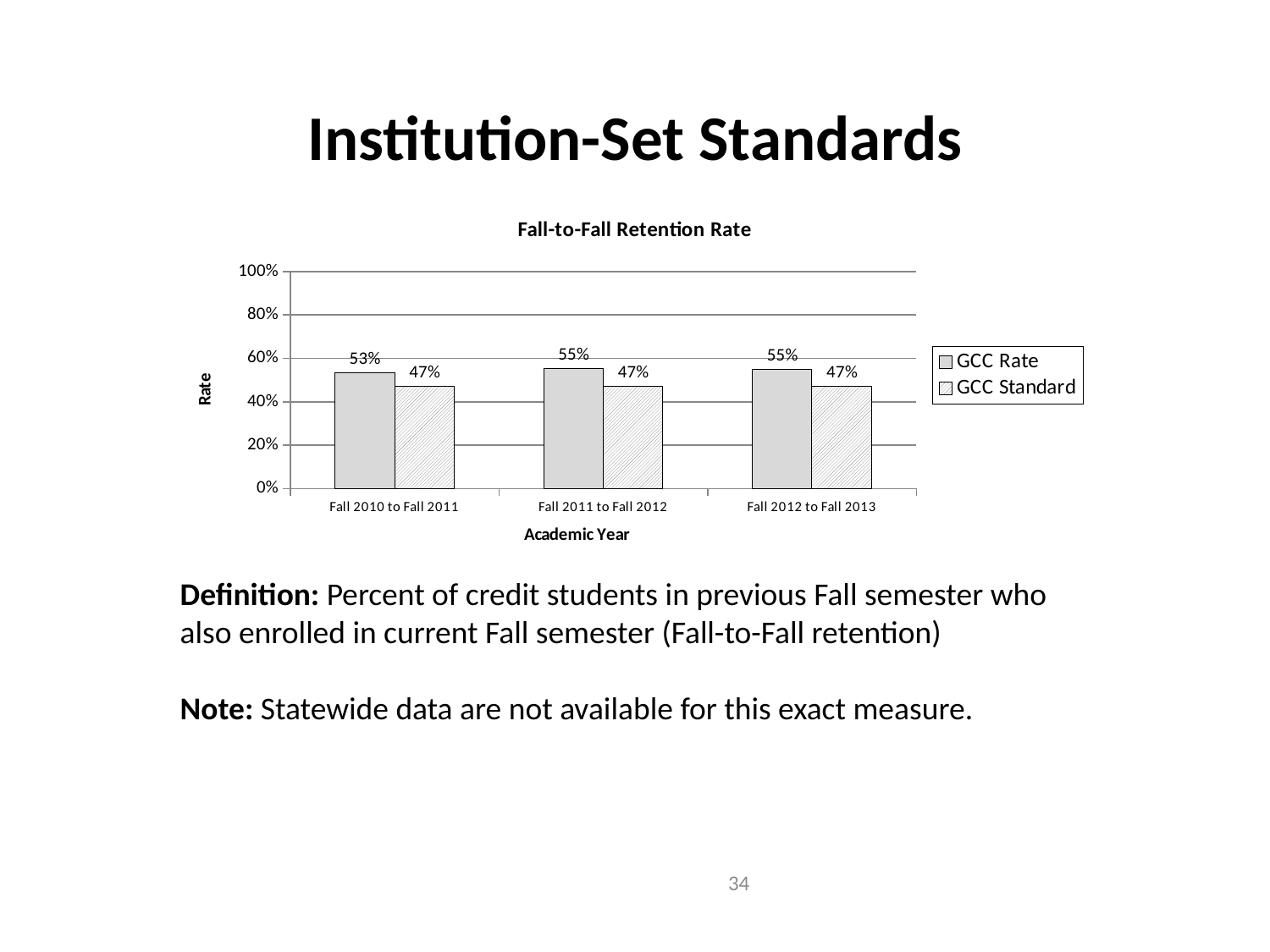
What is the difference between the GCC Rate and the GCC Standard for Fall 2011 to Fall 2012? 8% What kind of chart is shown on the slide? Bar chart What is the difference between the GCC Rate and the GCC Standard for Fall 2010 to Fall 2011? 6% How many academic years are shown on the x axis? 3 Which is larger for Fall 2012 to Fall 2013, the GCC Rate or the GCC Standard? GCC Rate What is the GCC Rate for Fall 2010 to Fall 2011? 53% How many series does the legend list? 2 What is the title of the chart? Fall-to-Fall Retention Rate Is the GCC Rate for Fall 2011 to Fall 2012 greater or less than 80%? less Which academic year has the lowest GCC Rate? Fall 2010 to Fall 2011 What is the GCC Rate for Fall 2011 to Fall 2012? 55% What is the GCC Standard for Fall 2012 to Fall 2013? 47%